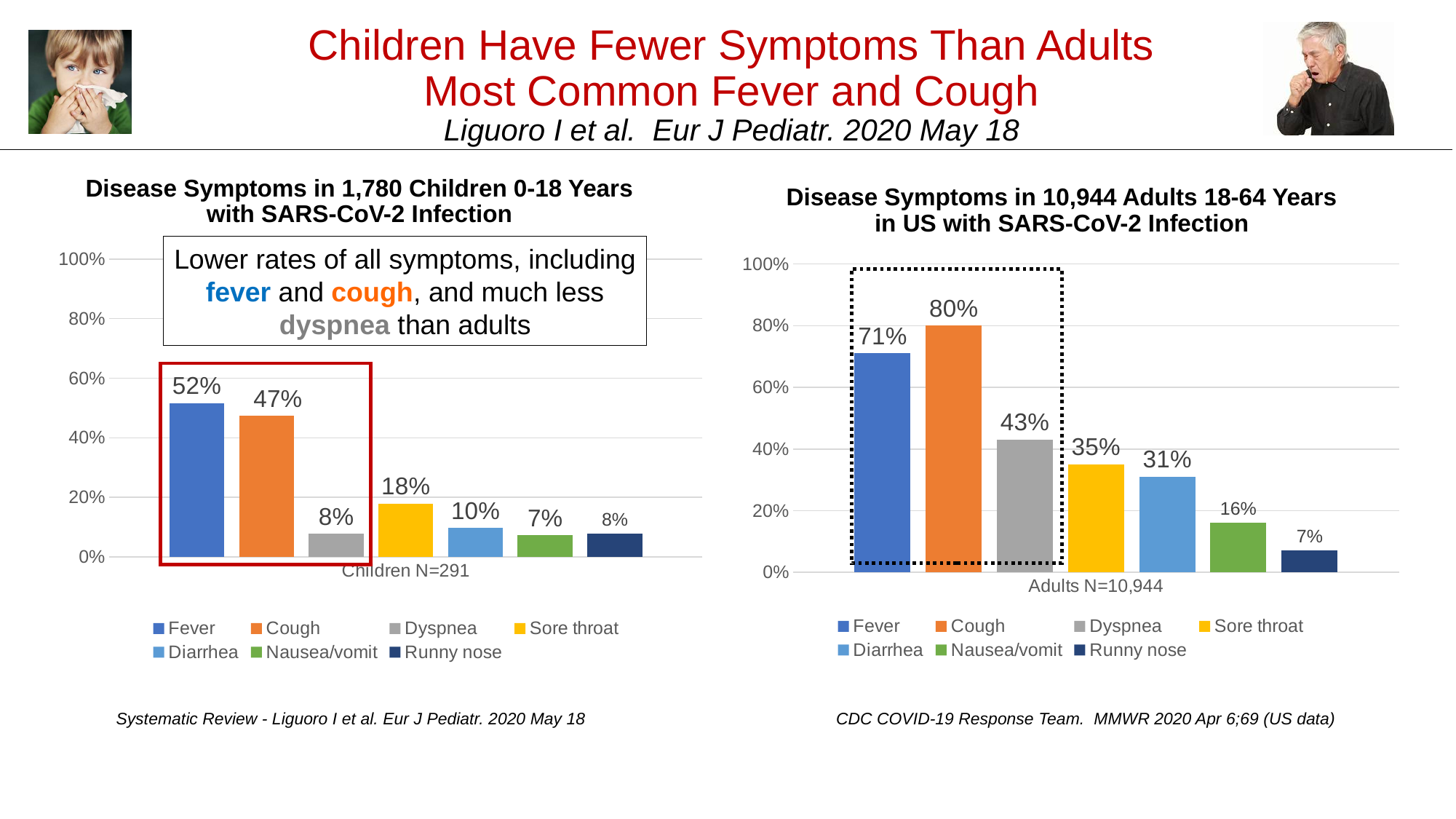
In the children's chart (left), which symptom has the lowest value? Nausea/vomit In the adults' chart (right), what is the value for Sore throat? 35% In the adults' chart (right), which symptom has the highest value? Cough In the adults' chart (right), what is the x-axis category label under the bars? Adults N=10,944 What kind of chart is the children's chart (left)? Bar chart In the adults' chart (right), what is the difference between the values for Fever and Dyspnea? 28% How many series does the legend of the adults' chart (right) list? 7 In the adults' chart (right), what is the value for Cough? 80% In the children's chart (left), what is the value for Dyspnea? 8% In the children's chart (left), which is larger, the value for Sore throat or the value for Diarrhea? Sore throat In the children's chart (left), what is the value for Fever? 52% In the children's chart (left), what colour is the Cough bar? Orange